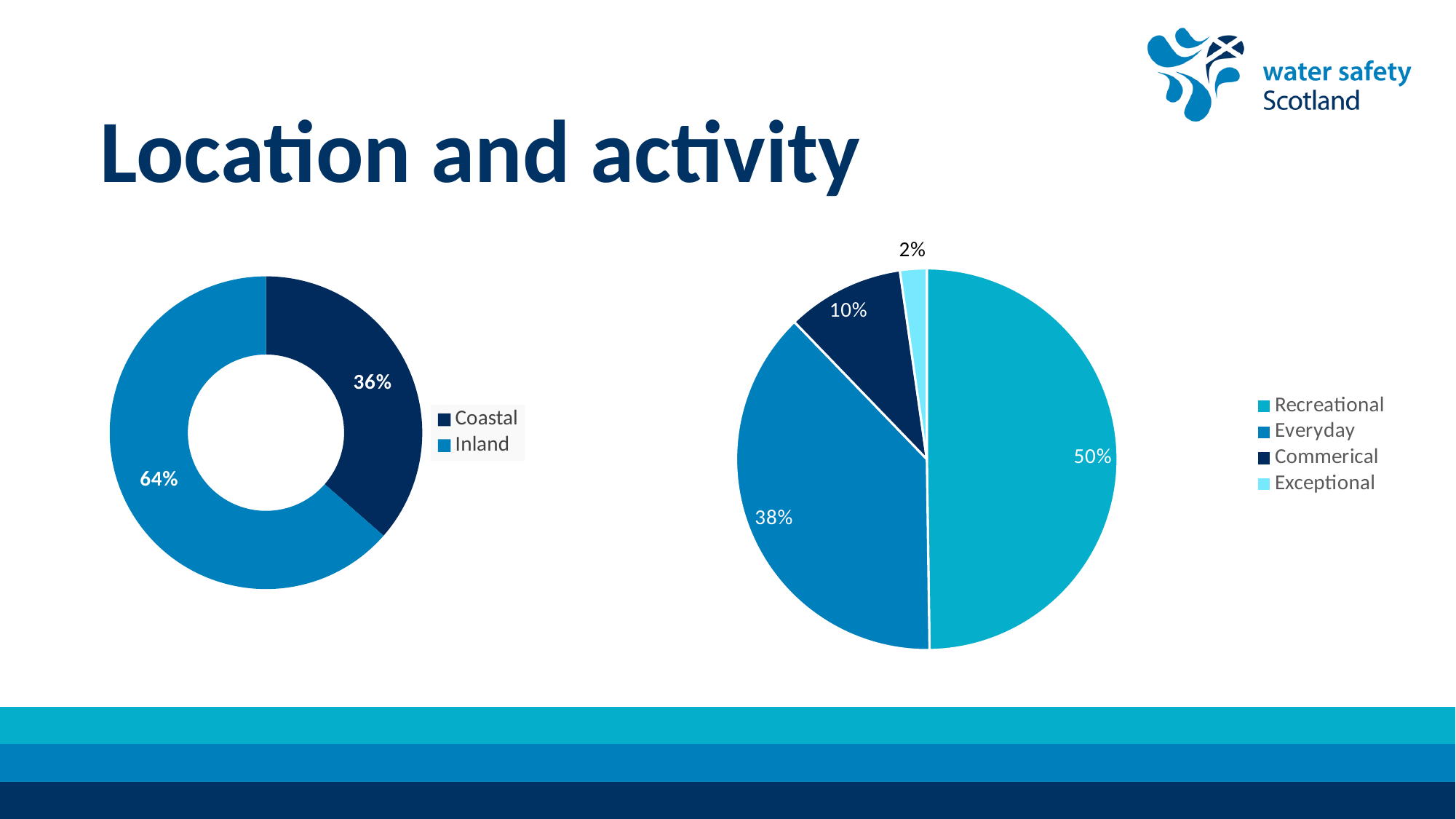
In the right chart (activity), what percentage is shown for Commerical? 10% In the right chart (activity), what is the difference between the Recreational and Everyday percentages? 12% In the right chart (activity), what percentage is shown for Recreational? 50% In the right chart (activity), which category has the smallest share? Exceptional In the left chart (Coastal/Inland), what is the difference between the Inland and Coastal percentages? 28% What kind of chart is the right chart (activity)? Pie chart In the left chart (Coastal/Inland), what percentage is shown for Inland? 64% In the left chart (Coastal/Inland), what percentage is shown for Coastal? 36% In the left chart (Coastal/Inland), which category has the larger share? Inland In the right chart (activity), what percentage is shown for Everyday? 38% In the right chart (activity), how many categories does the legend list? 4 What kind of chart is the left chart (Coastal/Inland)? Doughnut chart